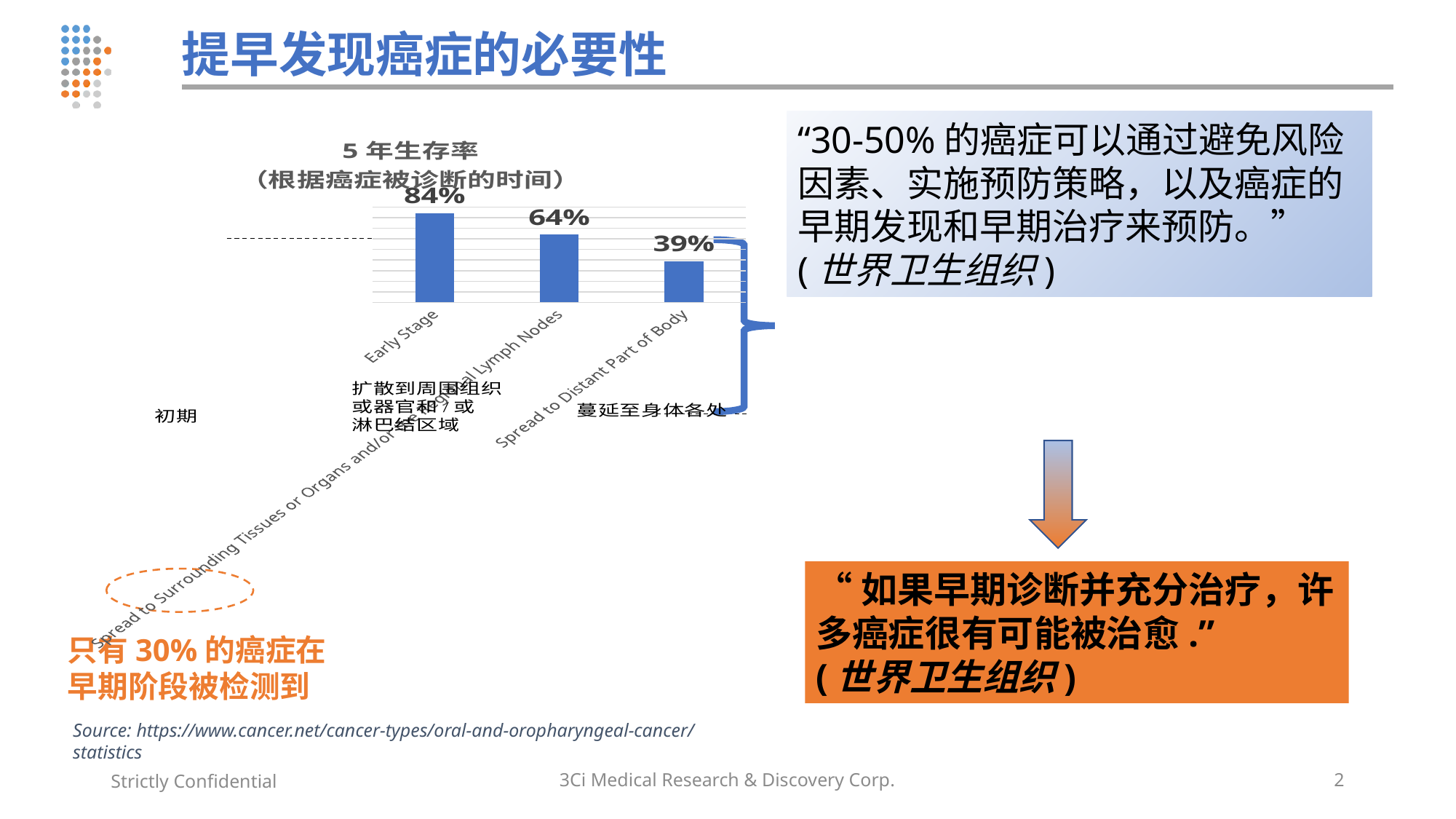
What is the difference between the survival rates for Early Stage and Spread to Surrounding Tissues or Organs and/or Regional Lymph Nodes? 20% Which stage has the lowest 5-year survival rate? Spread to Distant Part of Body What is the 5-year survival rate for Spread to Distant Part of Body? 39% What is the 5-year survival rate for Early Stage? 84% What is the 5-year survival rate for Spread to Surrounding Tissues or Organs and/or Regional Lymph Nodes? 64% Which has a higher 5-year survival rate, Spread to Surrounding Tissues or Organs and/or Regional Lymph Nodes or Spread to Distant Part of Body? Spread to Surrounding Tissues or Organs and/or Regional Lymph Nodes Which stage has the highest 5-year survival rate? Early Stage Do the survival rates rise or fall from Early Stage to Spread to Distant Part of Body? Fall What is the title of the chart? 5 年生存率（根据癌症被诊断的时间） What type of chart is shown on the slide? Bar chart What is the difference between the survival rates for Early Stage and Spread to Distant Part of Body? 45% How many stages are shown in the chart? 3